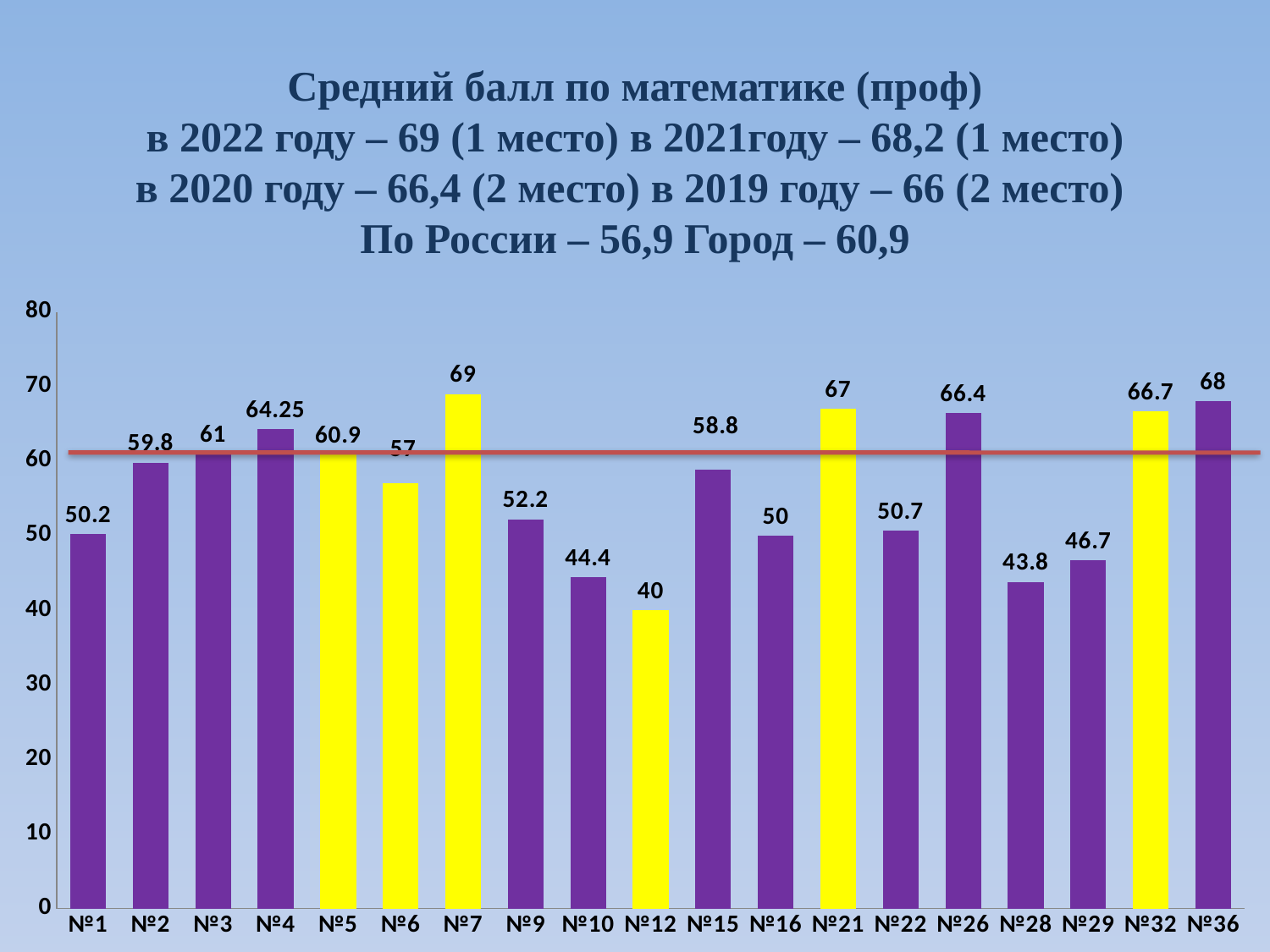
How many categories are shown on the x axis? 19 Which is larger, the value for №2 or the value for №15? №2 Which category has the lowest value? №12 What is the difference between the values for №36 and №26? 1.6 What kind of chart is shown on the slide? bar chart What is the value for №21? 67 Which category has the highest value? №7 What colour is the bar for №32? yellow What is the value for №28? 43.8 Is the value for №10 greater or less than 50? less What is the difference between the values for №7 and №12? 29 What is the value for №4? 64.25